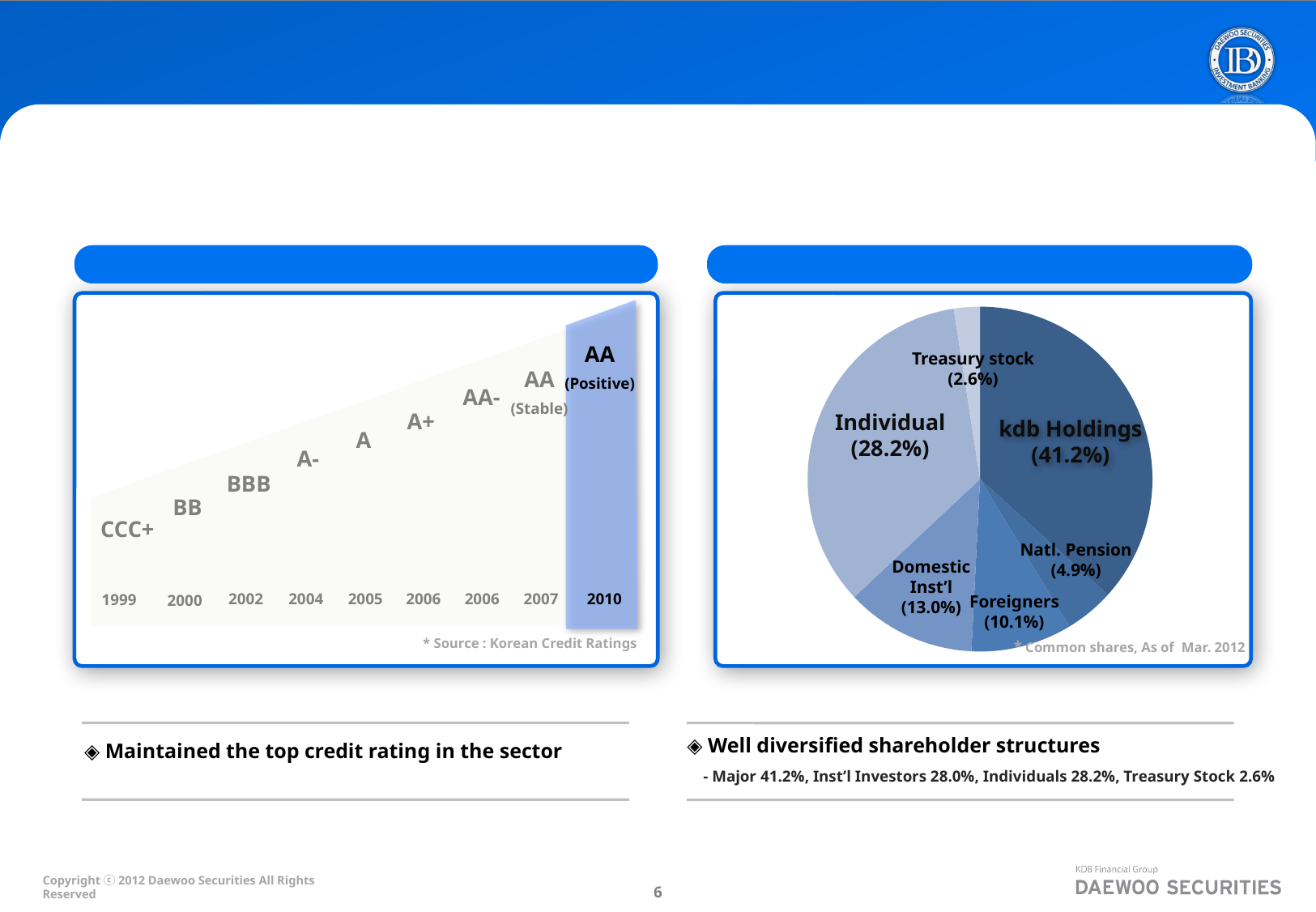
What type of chart is shown on the right side of the slide? Pie chart In the pie chart on the right, which is larger: Domestic Inst'l or Foreigners? Domestic Inst'l In the pie chart on the right, which slice is the smallest? Treasury stock In the pie chart on the right, what share is held by Individual shareholders? 28.2% In the credit rating chart on the left, what was the rating in 1999? CCC+ In the credit rating chart on the left, what was the rating in 2010? AA (Positive) In the pie chart on the right, what share is held by kdb Holdings? 41.2% In the pie chart on the right, how many percentage points larger is the kdb Holdings share than the Individual share? 13.0 percentage points How many slices does the pie chart on the right have? 6 In the credit rating chart on the left, what source is cited? Korean Credit Ratings In the pie chart on the right, which shareholder group has the largest share? kdb Holdings In the pie chart on the right, what share is held by Natl. Pension? 4.9%